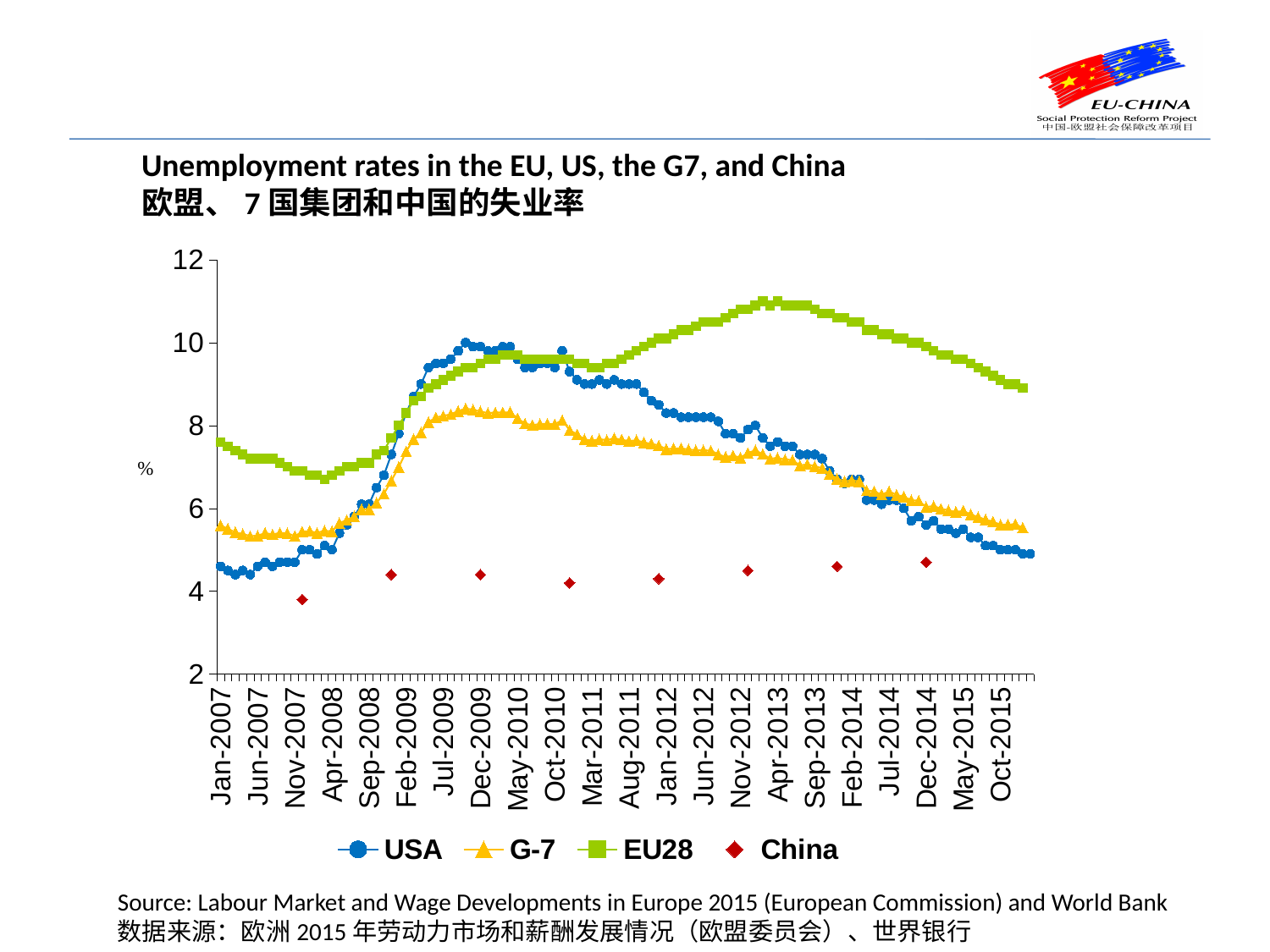
Which series has the lowest values throughout the chart? China Is the value for USA in Jan-2007 greater or less than 6? less What kind of chart is shown on the slide? line chart Which series are listed in the legend? USA, G-7, EU28, China Is the value for EU28 in Apr-2013 greater or less than 10? greater In Apr-2013, which is larger, the value for EU28 or the value for USA? EU28 Is the value for USA in Oct-2015 greater or less than 6? less What is the title of the chart in English? Unemployment rates in the EU, US, the G7, and China Does the EU28 series rise or fall from Apr-2013 to Oct-2015? fall How many series does the legend list? 4 Which series has the highest value in Oct-2015? EU28